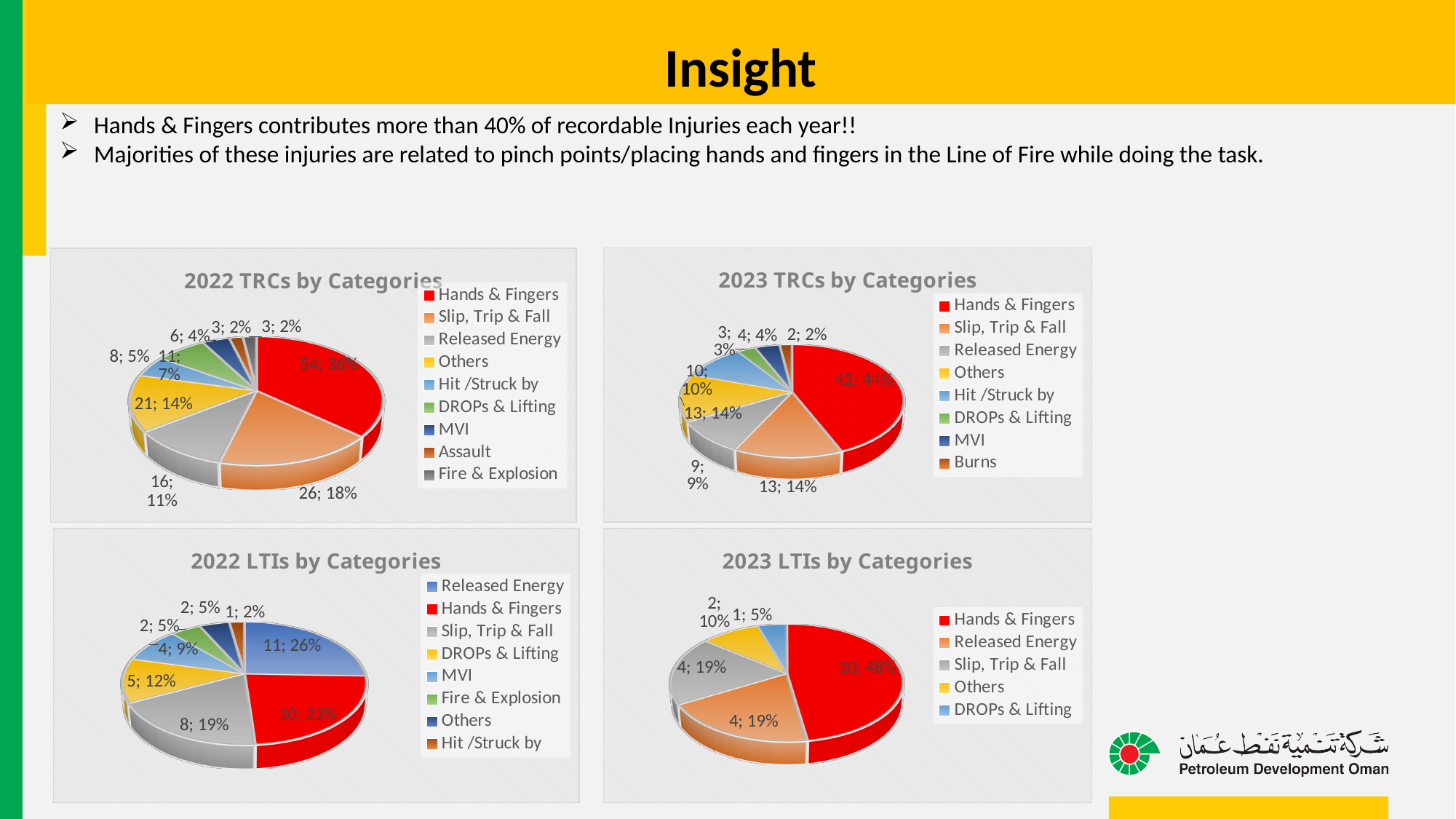
In the 2022 TRCs by Categories chart, what is the value and share for Hands & Fingers? 54; 36% What type of chart is the 2023 LTIs by Categories chart? Pie chart In the 2023 TRCs by Categories chart, what is the value and share for Burns? 2; 2% In the 2022 TRCs by Categories chart, which category has the largest slice? Hands & Fingers How many categories does the legend of the 2023 LTIs by Categories chart list? 5 In the 2023 TRCs by Categories chart, which is larger: Hit /Struck by or Burns? Hit /Struck by In the 2022 LTIs by Categories chart, which category has the largest slice? Released Energy In the 2022 TRCs by Categories chart, what is the difference in count between Hands & Fingers (54) and Slip, Trip & Fall (26)? 28 In the 2023 LTIs by Categories chart, what share of the pie does Hands & Fingers represent? 48% In the 2023 TRCs by Categories chart, what share of the pie does Hands & Fingers represent? 44% How many categories does the legend of the 2022 TRCs by Categories chart list? 9 In the 2022 LTIs by Categories chart, what is the value and share for Slip, Trip & Fall? 8; 19%